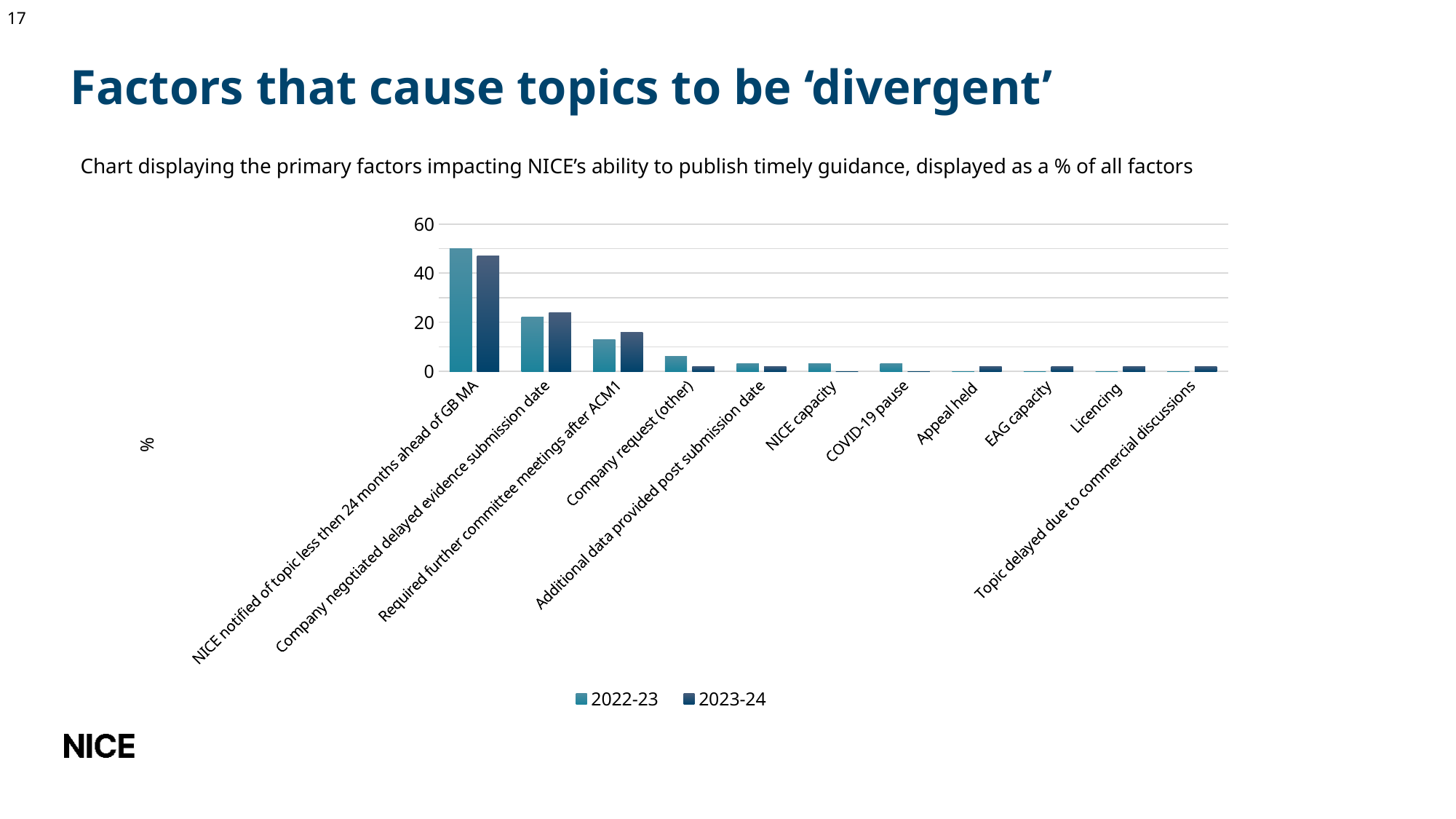
How many series does the chart legend list? 2 Which factor has the highest value for 2022-23? NICE notified of topic less then 24 months ahead of GB MA What are the two series named in the chart legend? 2022-23 and 2023-24 Is the 2022-23 value for 'NICE notified of topic less then 24 months ahead of GB MA' greater or less than 40? greater Which is larger: the 2022-23 value for 'Company request (other)' or the 2023-24 value for 'Company request (other)'? 2022-23 How many factor categories are shown on the x axis of the chart? 11 Do the 2022-23 values generally rise or fall moving from left to right along the x axis? Fall What kind of chart is shown on the slide? Bar chart Which is larger: the 2023-24 value for 'Required further committee meetings after ACM1' or the 2022-23 value for 'Required further committee meetings after ACM1'? 2023-24 Is the 2023-24 value for 'Required further committee meetings after ACM1' greater or less than 20? less Which factor has the highest value for 2023-24? NICE notified of topic less then 24 months ahead of GB MA